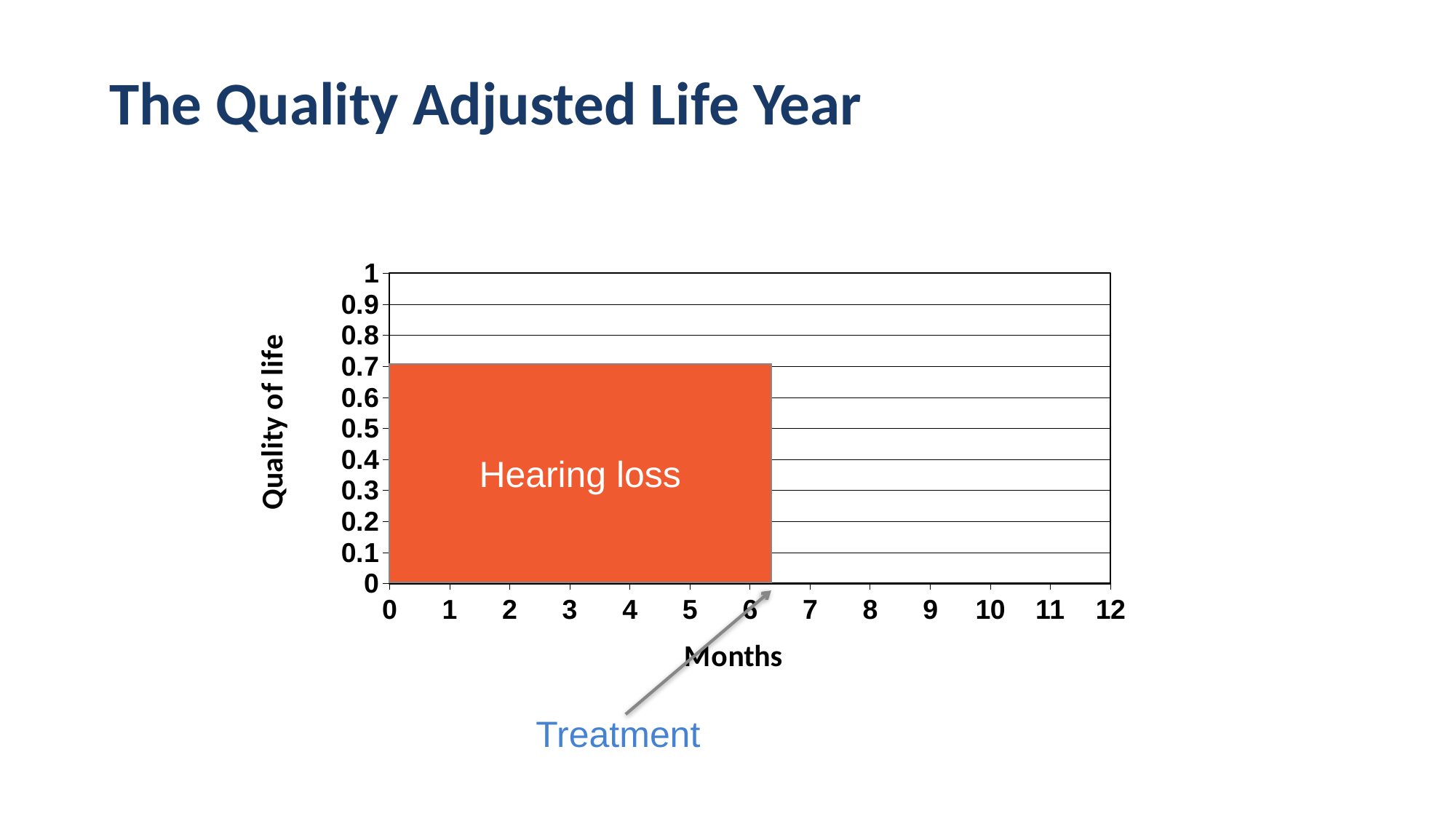
Is the quality of life value for Hearing loss greater or less than 0.8? less Does the Hearing loss area end before or after month 7 on the x axis? before Is the quality of life value for Hearing loss greater or less than 0.5? greater What quality of life value does the Hearing loss area reach on the y axis? 0.7 What label is written inside the orange area of the chart? Hearing loss At which month does the Hearing loss area begin on the x axis? 0 How many shaded areas are plotted on the chart? 1 What does the arrow pointing at the end of the orange area label? Treatment